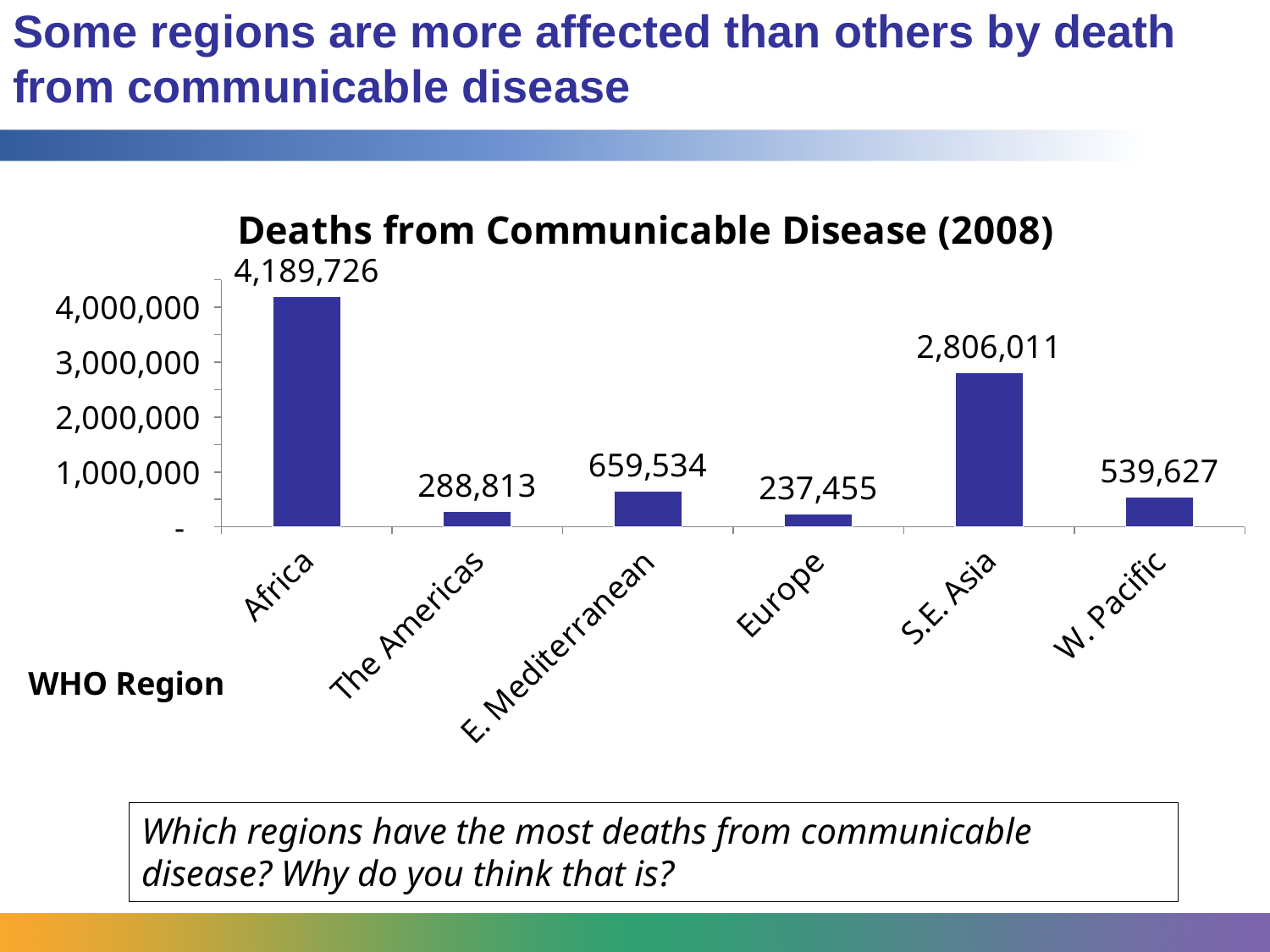
Which has more deaths from communicable disease, W. Pacific or E. Mediterranean? E. Mediterranean What is the number of deaths from communicable disease for Europe? 237,455 What is the number of deaths from communicable disease for Africa? 4,189,726 What is the number of deaths from communicable disease for W. Pacific? 539,627 Which WHO region has the highest number of deaths from communicable disease? Africa What is the number of deaths from communicable disease for S.E. Asia? 2,806,011 Which WHO region has the lowest number of deaths from communicable disease? Europe How many WHO regions are shown in the chart? 6 What is the title of the chart? Deaths from Communicable Disease (2008) What is the difference in deaths from communicable disease between Africa and S.E. Asia? 1,383,715 What is the difference in deaths from communicable disease between E. Mediterranean and The Americas? 370,721 What kind of chart is shown on the slide? Bar chart